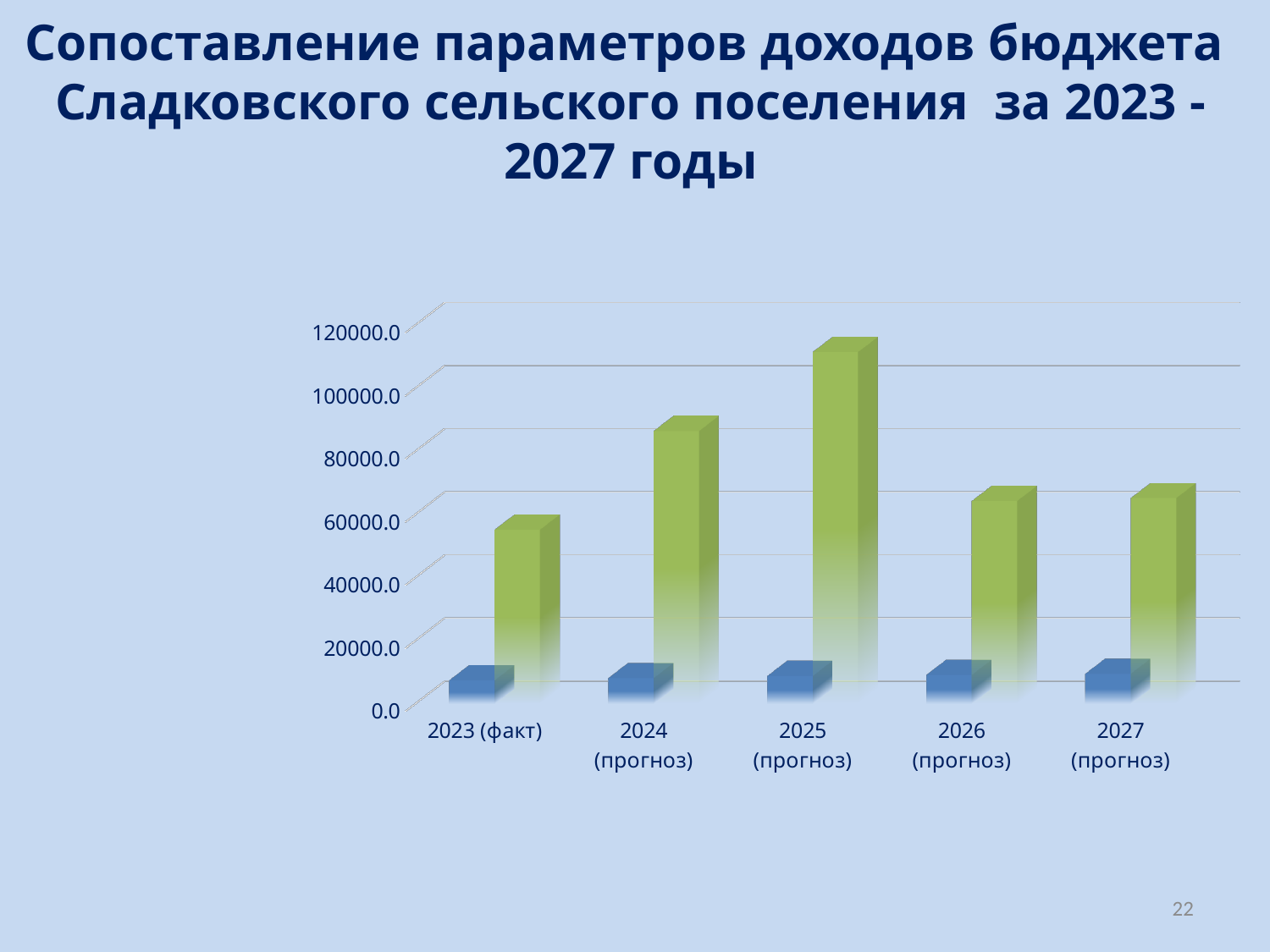
Is the green bar for 2026 (прогноз) greater or less than 40000.0? greater Is the green bar for 2025 (прогноз) greater or less than 100000.0? greater Is the green bar for 2024 (прогноз) greater or less than 80000.0? greater Do the green bars rise or fall from 2023 (факт) to 2025 (прогноз)? rise What kind of chart is shown on the slide? bar chart What is the highest value labelled on the vertical axis of the chart? 120000.0 How many year categories are shown on the x axis of the chart? 5 Which year has the shortest green bar? 2023 (факт) Which green bar is taller: 2024 (прогноз) or 2026 (прогноз)? 2024 (прогноз) Which year has the tallest green bar? 2025 (прогноз)